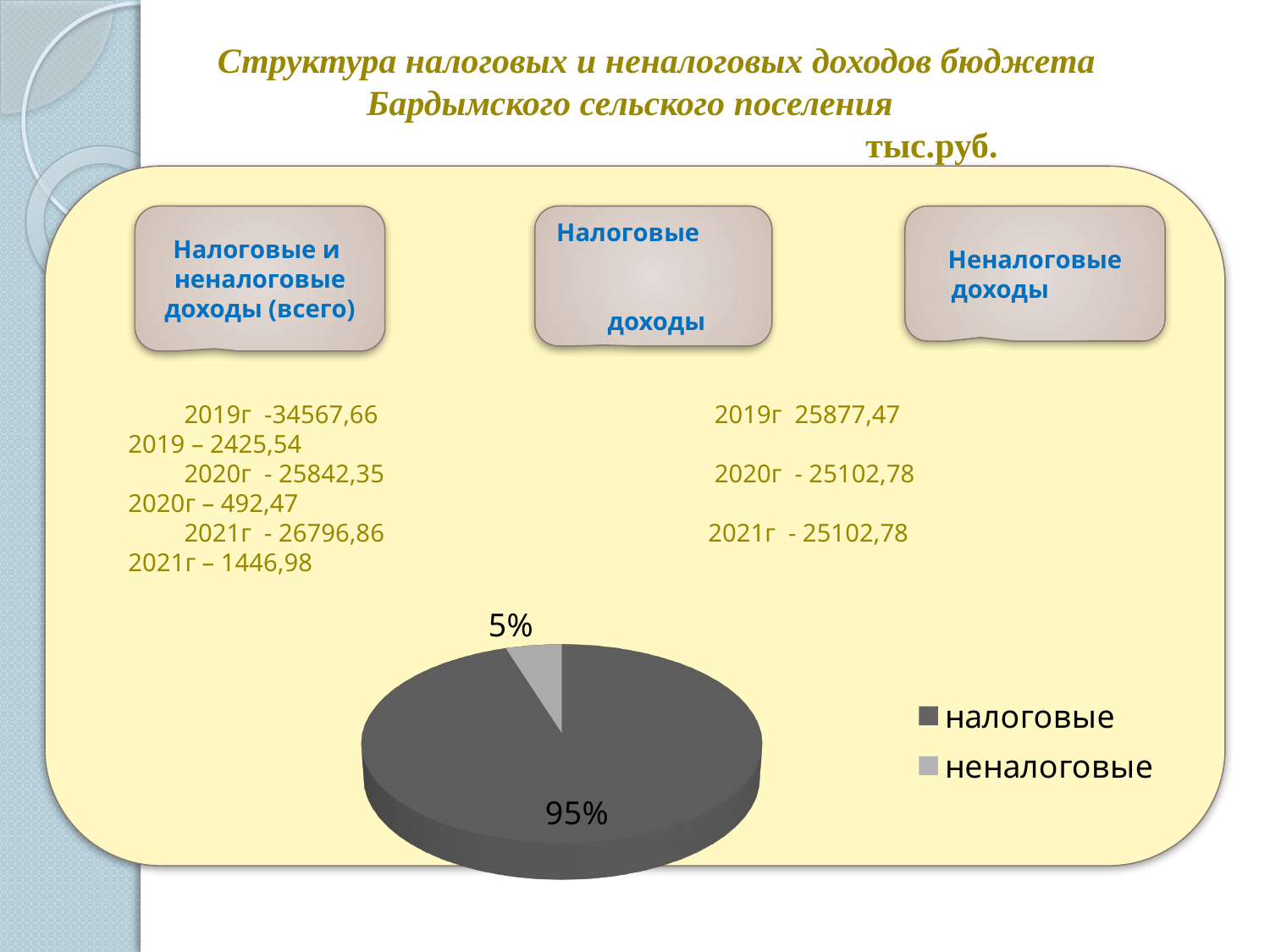
What is the difference in percentage points between the "налоговые" and "неналоговые" slices? 90 Which slice of the pie chart is the smallest? неналоговые Which slice of the pie chart is the largest? налоговые What colour is the "налоговые" slice in the pie chart? dark grey What share of the pie chart does the "налоговые" slice represent? 95% What share of the pie chart does the "неналоговые" slice represent? 5% What kind of chart is shown on the slide? pie chart What colour is the "неналоговые" slice in the pie chart? light grey How many slices does the pie chart have? 2 How many entries does the pie chart's legend list? 2 Which is larger in the pie chart: "налоговые" or "неналоговые"? налоговые